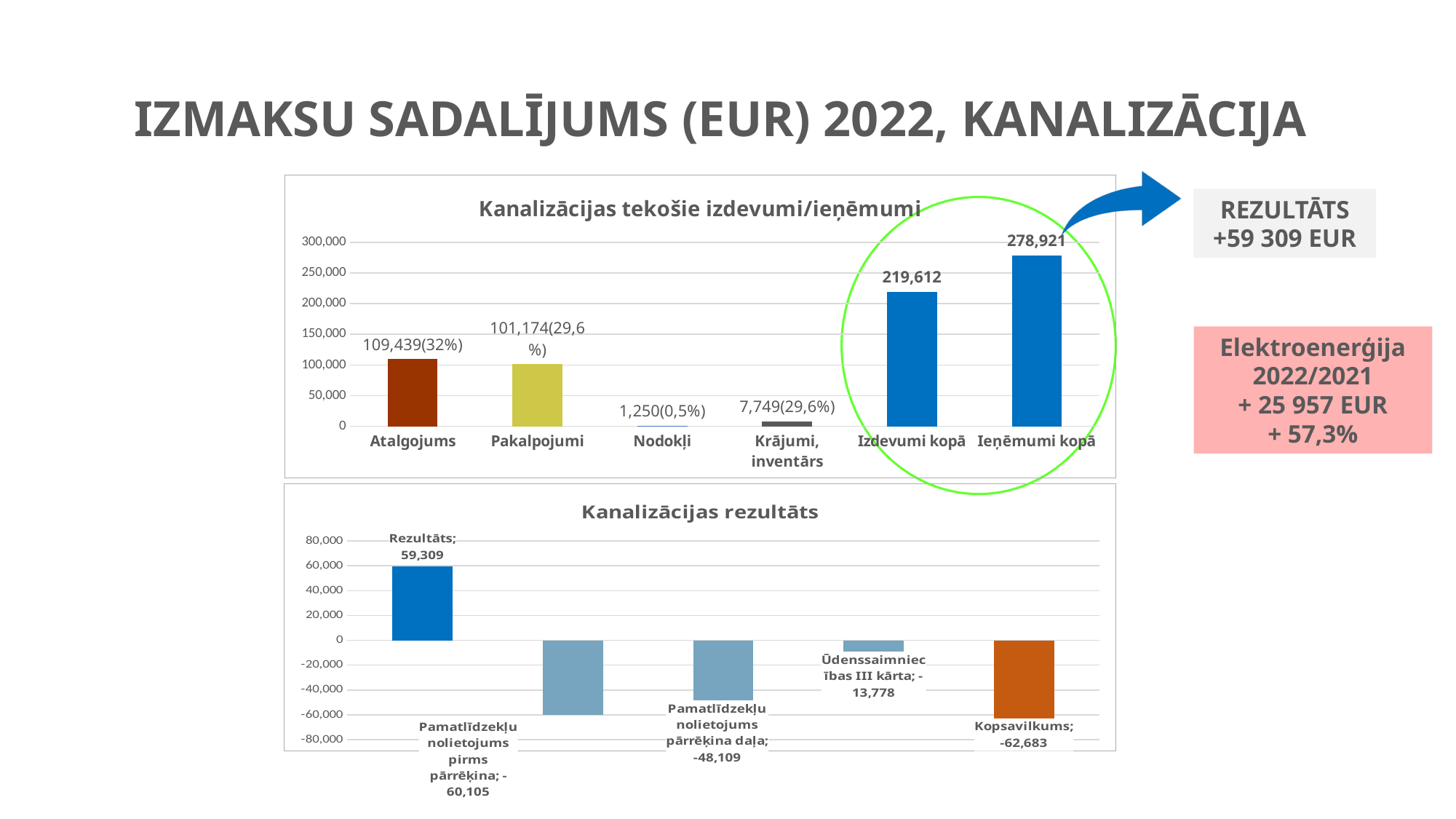
In the chart titled "Kanalizācijas tekošie izdevumi/ieņēmumi", which category has the lowest value? Nodokļi In the chart titled "Kanalizācijas rezultāts", what is the value for Kopsavilkums? -62,683 In the chart titled "Kanalizācijas rezultāts", which is larger in absolute value: Pamatlīdzekļu nolietojums pārrēķina daļa or Ūdenssaimniecības III kārta? Pamatlīdzekļu nolietojums pārrēķina daļa What kind of chart is the chart titled "Kanalizācijas rezultāts"? bar chart In the chart titled "Kanalizācijas tekošie izdevumi/ieņēmumi", which category has the highest value? Ieņēmumi kopā In the chart titled "Kanalizācijas tekošie izdevumi/ieņēmumi", what is the value for Ieņēmumi kopā? 278,921 In the chart titled "Kanalizācijas tekošie izdevumi/ieņēmumi", how many categories are shown on the x axis? 6 In the chart titled "Kanalizācijas rezultāts", what is the value for Rezultāts? 59,309 In the chart titled "Kanalizācijas tekošie izdevumi/ieņēmumi", what is the data label shown for Atalgojums? 109,439(32%) In the chart titled "Kanalizācijas tekošie izdevumi/ieņēmumi", what is the value for Izdevumi kopā? 219,612 In the chart titled "Kanalizācijas tekošie izdevumi/ieņēmumi", what is the difference between Ieņēmumi kopā and Izdevumi kopā? 59,309 In the chart titled "Kanalizācijas tekošie izdevumi/ieņēmumi", is the value for Pakalpojumi greater or less than 150,000? less